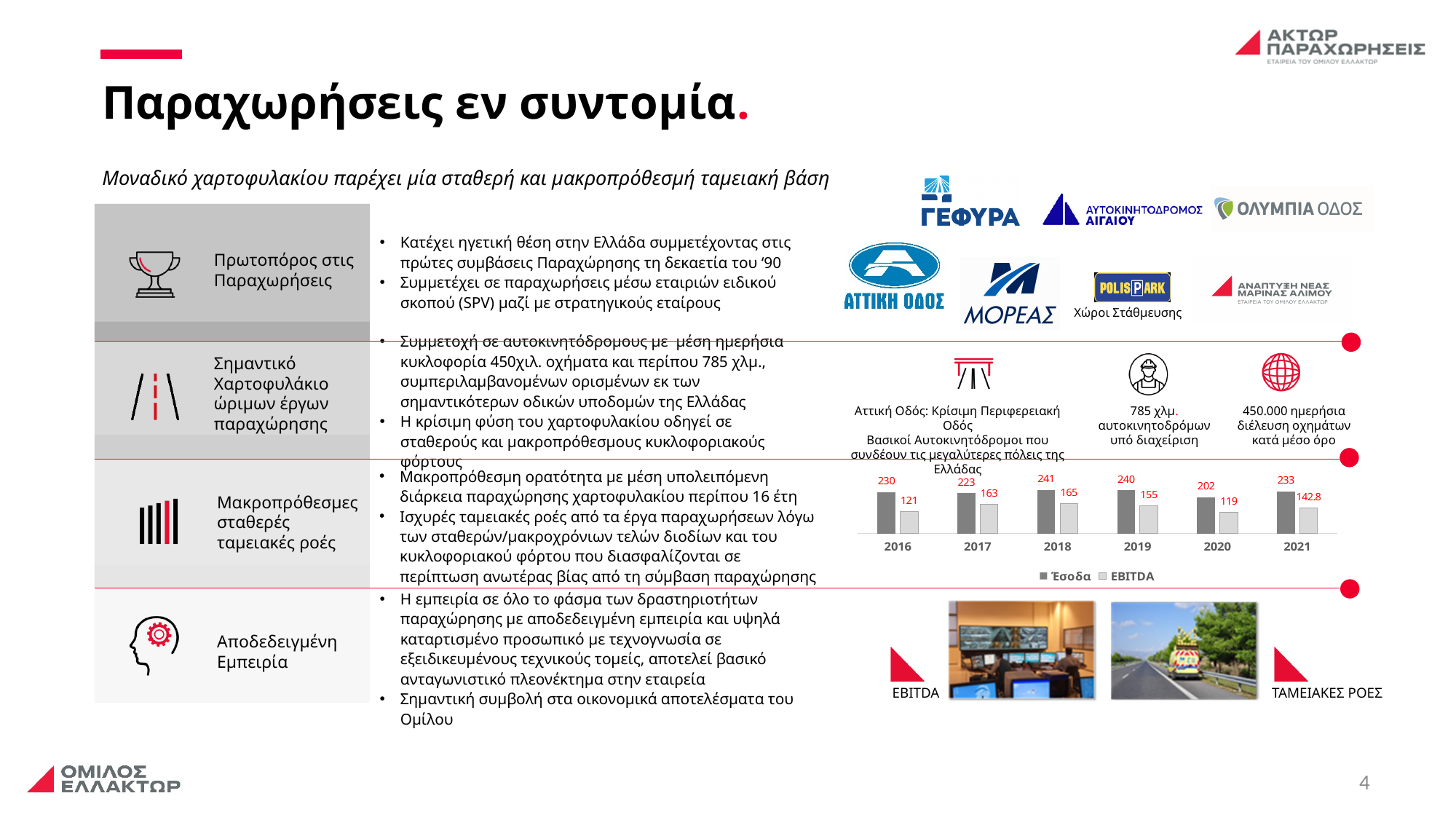
Which is larger, EBITDA in 2019 or EBITDA in 2020? EBITDA in 2019 What is the difference between Έσοδα in 2018 and Έσοδα in 2020? 39 In which year is EBITDA the highest? 2018 In which year is Έσοδα the lowest? 2020 In which year is EBITDA the lowest? 2020 What type of chart is used to show Έσοδα and EBITDA? Bar chart What is the EBITDA value for 2021? 142.8 How many series does the chart legend list? 2 What is the EBITDA value for 2017? 163 How many years are shown on the x axis of the chart? 6 What is the value of Έσοδα for 2018? 241 What is the difference between Έσοδα and EBITDA in 2016? 109